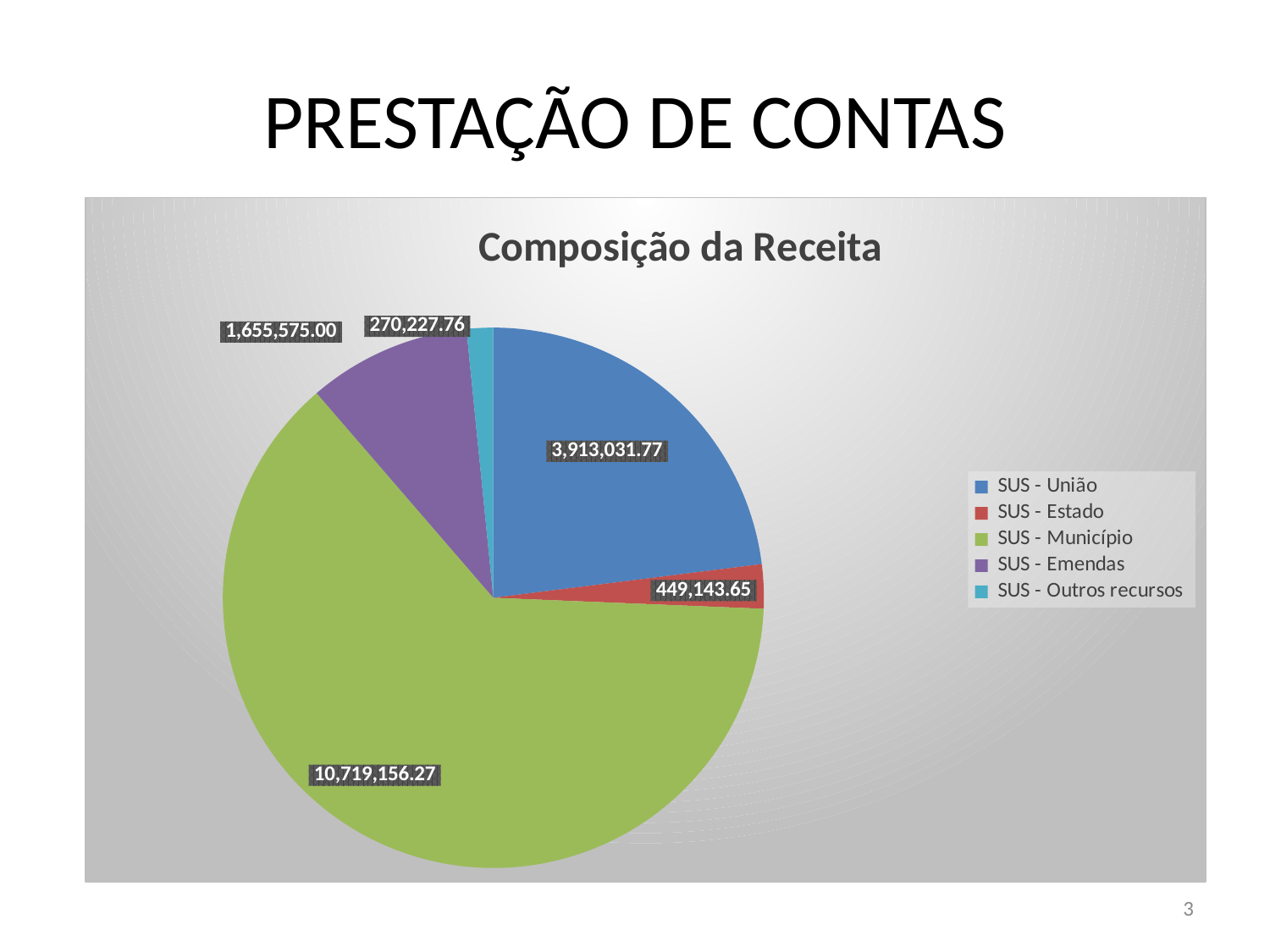
Which is larger, the value for SUS - União or the value for SUS - Emendas? SUS - União What is the difference between the values for SUS - Emendas and SUS - Outros recursos? 1,385,347.24 What is the value for SUS - Estado in the pie chart? 449,143.65 What is the value for SUS - Outros recursos in the pie chart? 270,227.76 Which category has the largest slice in the Composição da Receita pie chart? SUS - Município What type of chart is shown on the slide? Pie chart What is the value for SUS - Município in the Composição da Receita pie chart? 10,719,156.27 What is the difference between the values for SUS - Município and SUS - União? 6,806,124.50 What is the value for SUS - União in the pie chart? 3,913,031.77 What is the value for SUS - Emendas in the pie chart? 1,655,575.00 How many categories does the pie chart show? 5 Which category has the smallest slice in the pie chart? SUS - Outros recursos